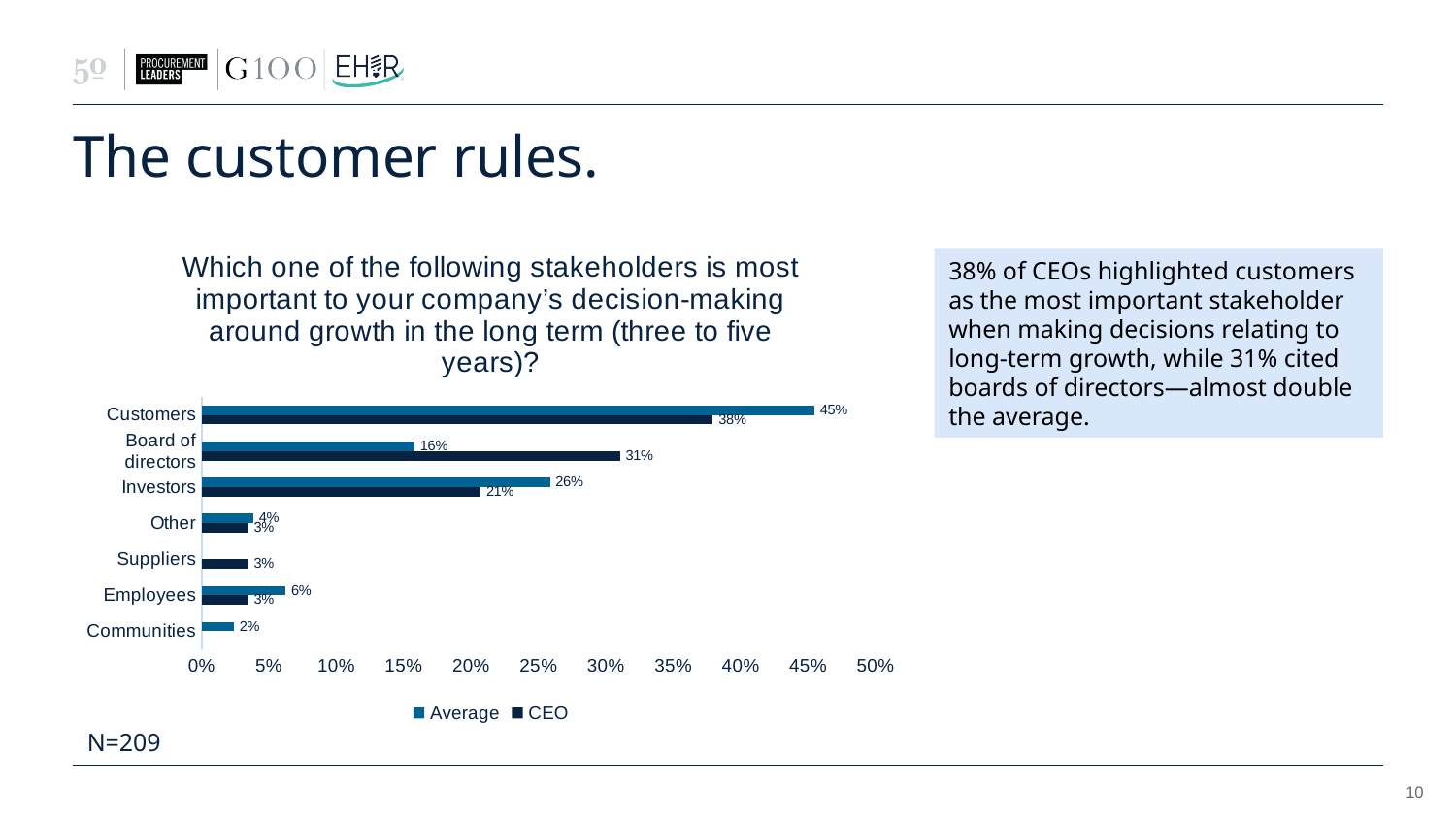
Is the CEO value for Customers greater or less than 35%? greater Which category has the highest CEO value? Customers What is the CEO value for Employees? 3% What is the Average value for Investors? 26% How many stakeholder categories are shown on the chart? 7 What is the CEO value for Board of directors? 31% What is the difference between the Average and CEO values for Board of directors? 15% What is the Average value for Customers? 45% Which is larger for Investors, the Average value or the CEO value? Average How many series does the legend list? 2 What is the difference between the Average and CEO values for Customers? 7% What kind of chart is shown on the slide? Bar chart